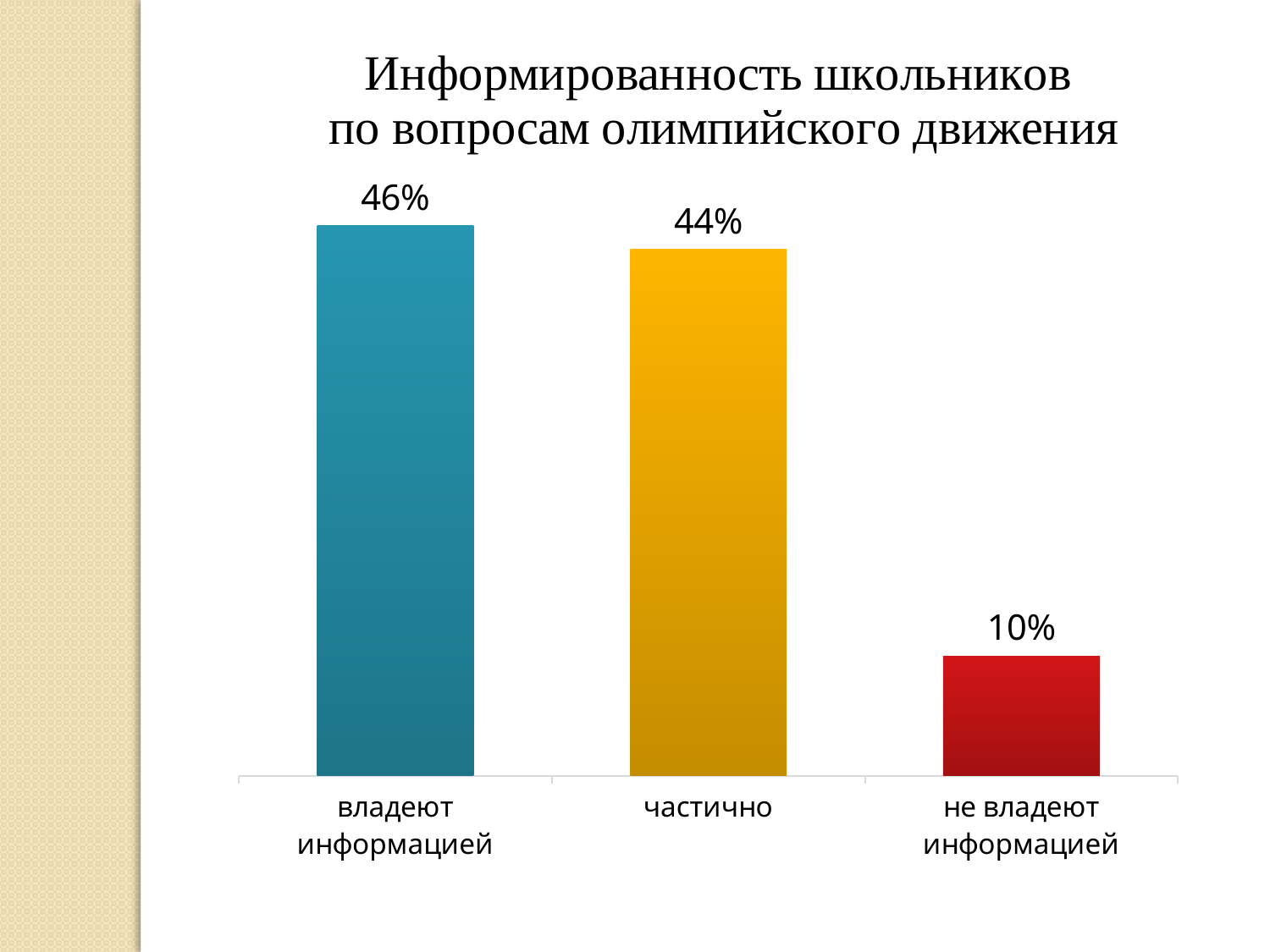
What is the difference between the values for "владеют информацией" and "частично"? 2% What colour is the bar for "не владеют информацией"? red What is the difference between the values for "частично" and "не владеют информацией"? 34% What is the value for "частично"? 44% Which category has the highest value? владеют информацией What is the value for "не владеют информацией"? 10% Which is larger: the value for "частично" or the value for "не владеют информацией"? частично What is the title of the chart? Информированность школьников по вопросам олимпийского движения What is the value for "владеют информацией"? 46% What kind of chart is shown on the slide? bar chart How many categories are shown in the chart? 3 Which category has the lowest value? не владеют информацией